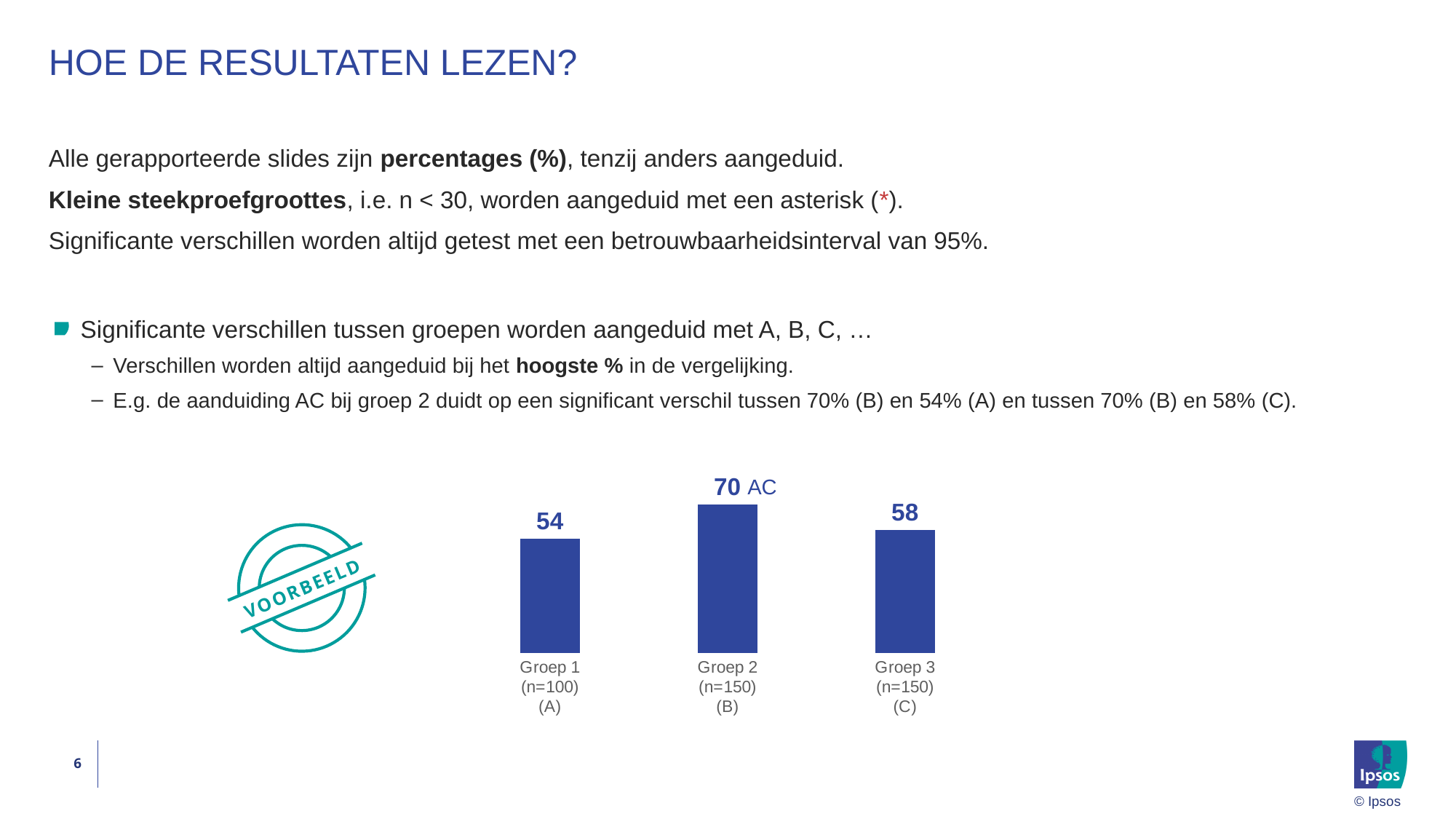
What is the difference between the values for Groep 3 and Groep 1? 4 Which letters are shown next to the data label of Groep 2? AC What is the difference between the values for Groep 2 and Groep 1? 16 What kind of chart is shown on the slide? Bar chart Which group has the highest value? Groep 2 What is the value for Groep 3 (C)? 58 What is the value for Groep 2 (B)? 70 What is the value for Groep 1 (A)? 54 Which group has the lowest value? Groep 1 How many groups are shown in the chart? 3 Which is larger, the value for Groep 3 or the value for Groep 1? Groep 3 What is the sample size (n) shown for Groep 1? n=100